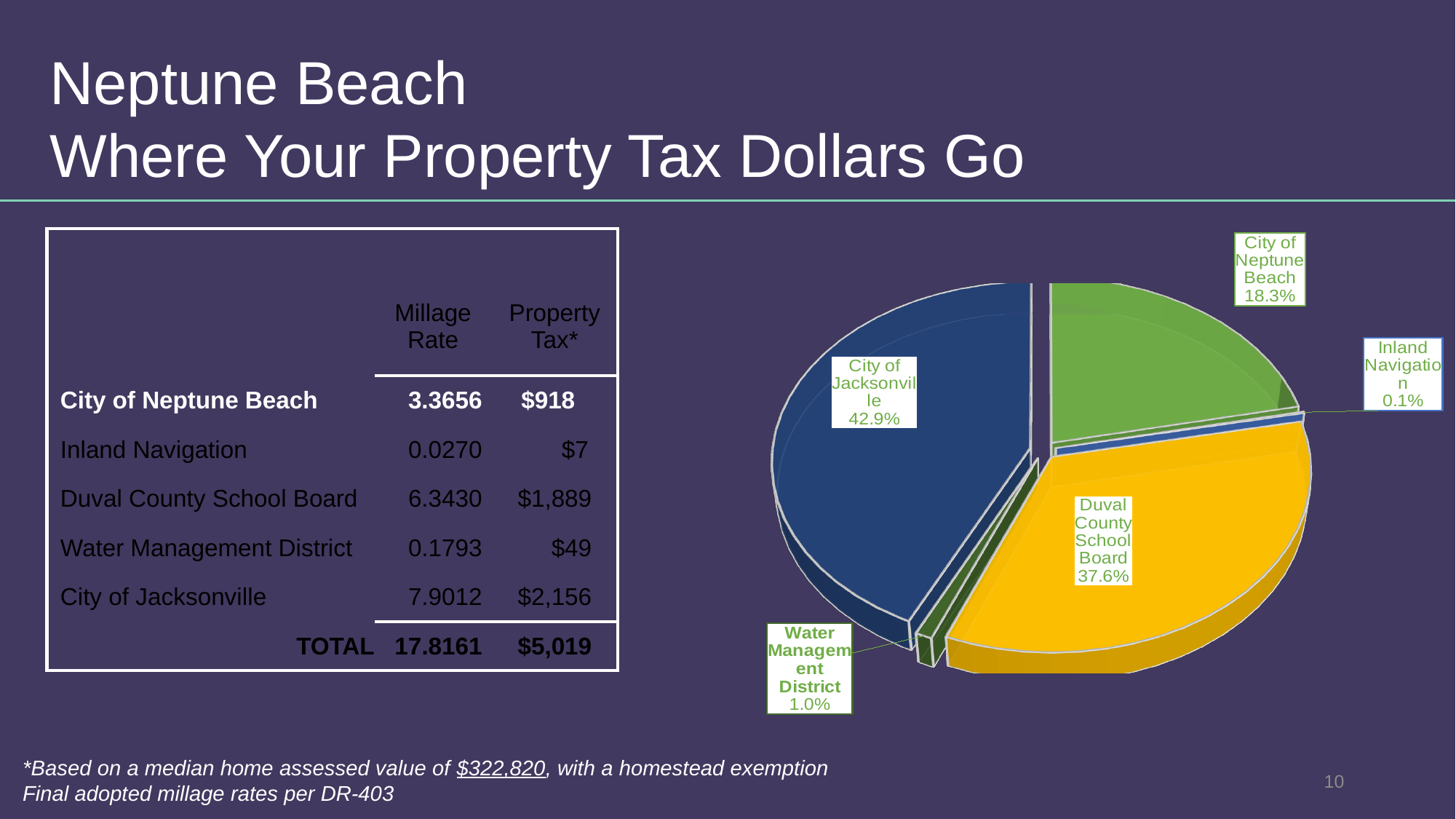
Which slice is larger, City of Neptune Beach or Duval County School Board? Duval County School Board What share of the pie does Duval County School Board represent? 37.6% What colour is the Duval County School Board slice in the pie chart? Yellow What share of the pie does Inland Navigation represent? 0.1% What kind of chart is shown on the slide? Pie chart What is the difference in percentage points between the City of Jacksonville slice and the Duval County School Board slice? 5.3 How many slices does the pie chart have? 5 Which slice of the pie chart is the smallest? Inland Navigation What share of the pie does City of Neptune Beach represent? 18.3% Which slice of the pie chart is the largest? City of Jacksonville